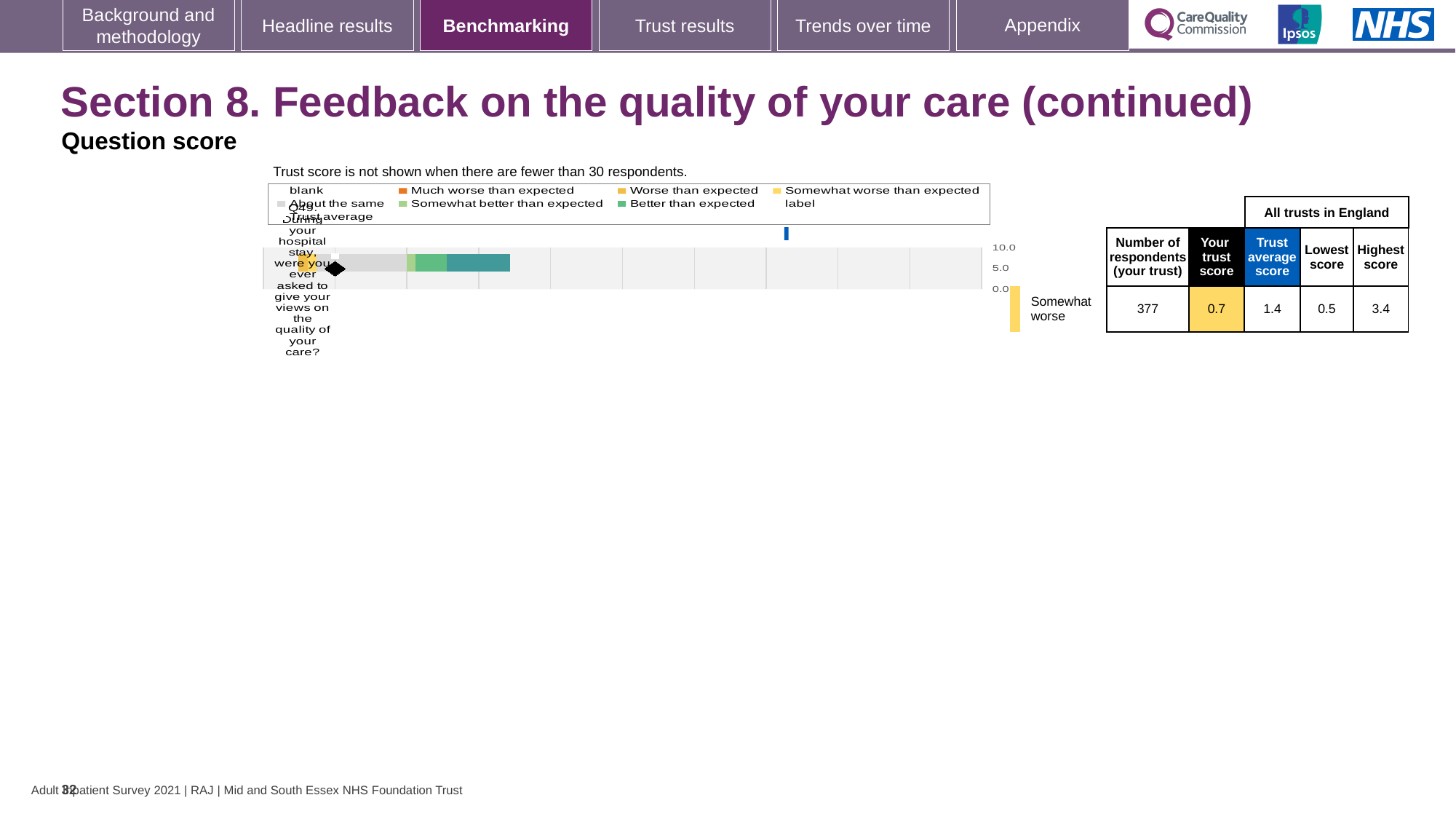
What is the highest value shown on the chart's axis? 10.0 What colour is used in the legend for 'Much worse than expected'? Orange What is the difference between the highest score and the lowest score across all trusts in England for Q49? 2.9 What is the difference between the trust average score and the trust score for Q49? 0.7 Which benchmarking band label is shown next to the chart for Q49? Somewhat worse Which is larger for Q49: the trust score or the trust average score? Trust average score What is the trust score for Q49 shown on the slide? 0.7 What is the trust average score for Q49 shown on the slide? 1.4 How many respondents from the trust answered Q49? 377 How many questions (categories) are plotted on the benchmarking chart? 1 Is the trust score for Q49 greater or less than 5.0 on the chart axis? less What kind of chart is used to show the Q49 benchmarking result? bar chart